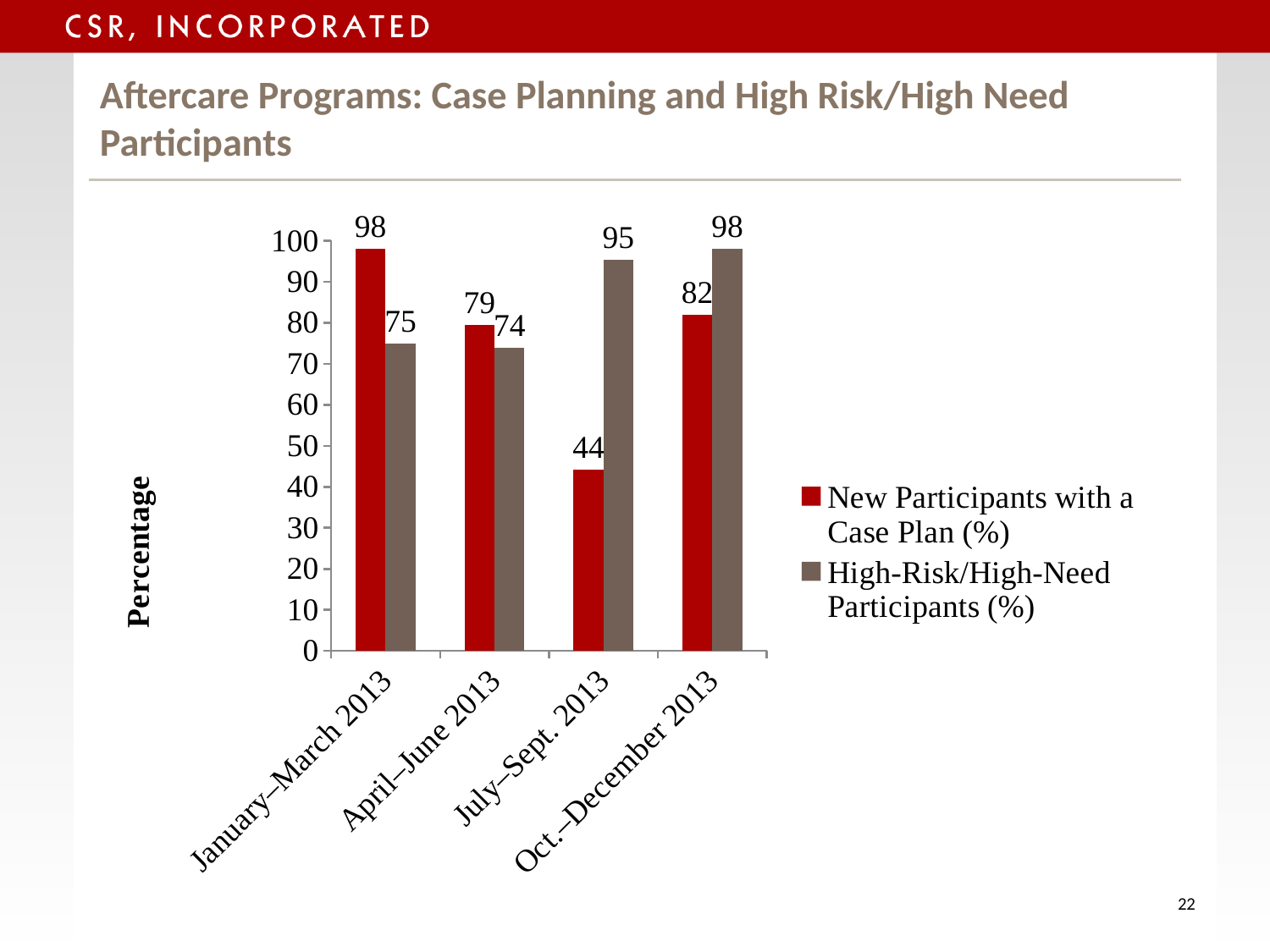
Which period has the lowest value for New Participants with a Case Plan (%)? July–Sept. 2013 What kind of chart is shown on the slide? Bar chart What is the value for New Participants with a Case Plan (%) in Oct.–December 2013? 82 How many series does the legend list? 2 What is the difference between New Participants with a Case Plan (%) in January–March 2013 and April–June 2013? 19 What is the label of the y axis? Percentage What is the value for New Participants with a Case Plan (%) in January–March 2013? 98 How many time periods are shown on the x axis? 4 In Oct.–December 2013, which series has the larger value: New Participants with a Case Plan (%) or High-Risk/High-Need Participants (%)? High-Risk/High-Need Participants (%) What is the difference between New Participants with a Case Plan (%) and High-Risk/High-Need Participants (%) in July–Sept. 2013? 51 Which period has the lowest value for High-Risk/High-Need Participants (%)? April–June 2013 What is the value for High-Risk/High-Need Participants (%) in July–Sept. 2013? 95